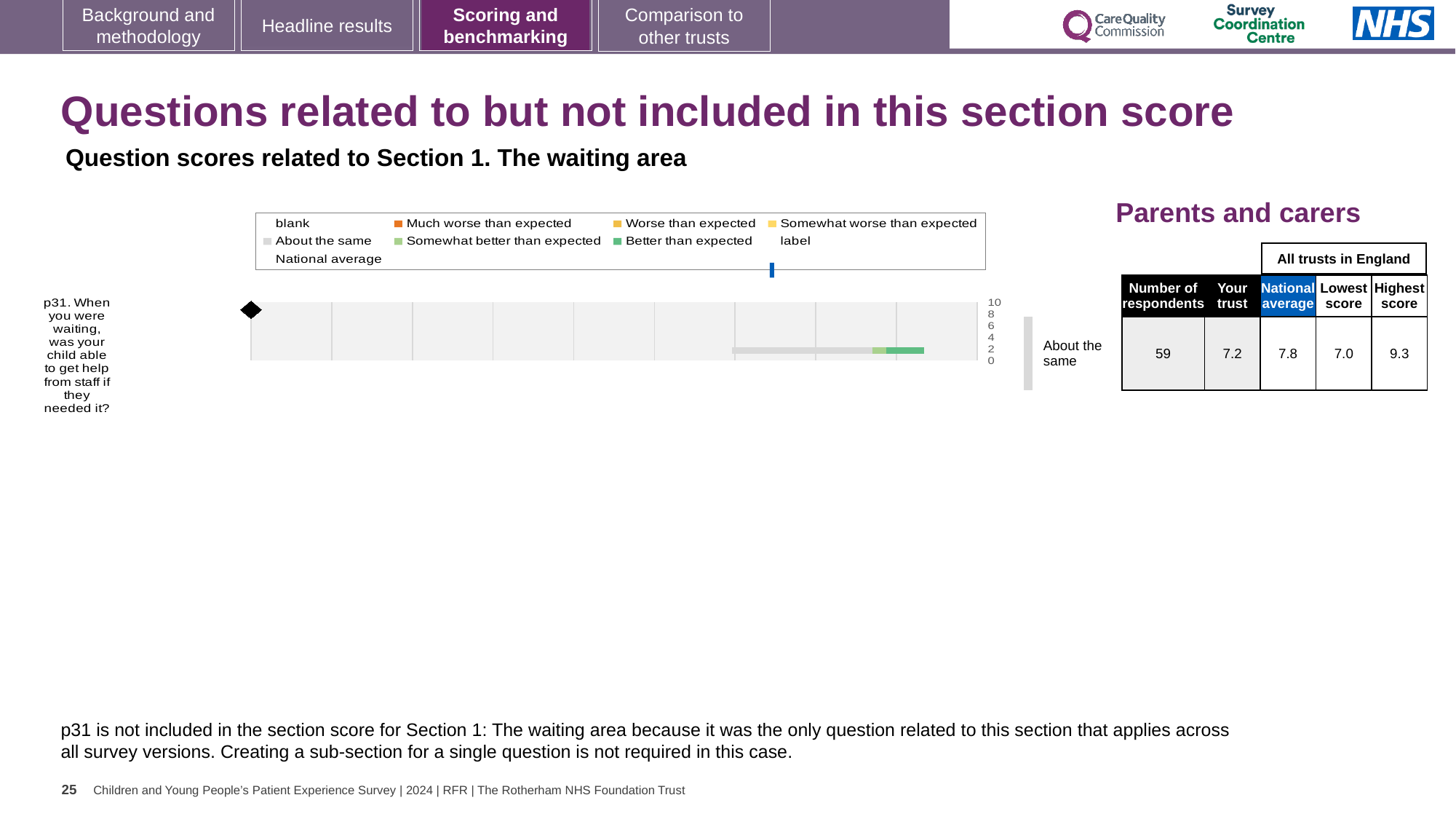
For question p31, what is the difference between the national average and the 'Your trust' score? 0.6 What is the national average score for question p31? 7.8 What is the lowest score among all trusts in England for question p31? 7.0 What benchmark category is shown next to the chart for question p31? About the same For question p31, what is the difference between the highest score and the lowest score among all trusts in England? 2.3 For question p31, which is larger: the 'Your trust' score or the national average? National average What kind of chart is used to show the question score for p31? Bar chart What is the 'Your trust' score for question p31 (When you were waiting, was your child able to get help from staff if they needed it?)? 7.2 Which section are the question scores in the chart related to? Section 1. The waiting area How many respondents answered question p31? 59 What is the highest score among all trusts in England for question p31? 9.3 How many questions are plotted in the chart? 1